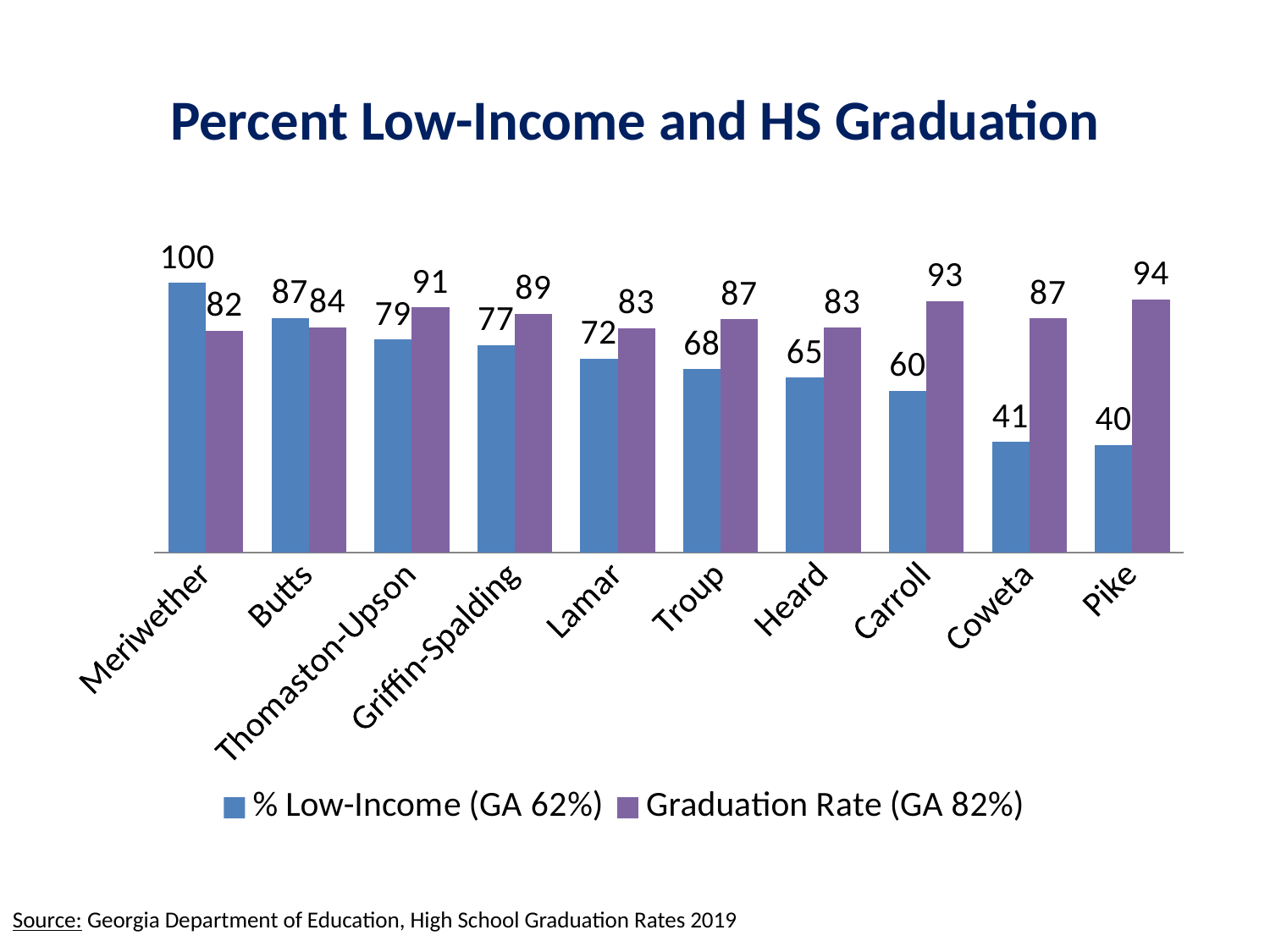
Which county has the lowest % Low-Income value? Pike What is the difference between the Graduation Rate and the % Low-Income value for Pike? 54 What is the Graduation Rate for Carroll? 93 How many counties are shown on the x axis? 10 Which is larger for Butts: the % Low-Income value or the Graduation Rate? % Low-Income What is the title of the chart? Percent Low-Income and HS Graduation What kind of chart is shown on the slide? Bar chart Do the % Low-Income values generally rise or fall from Meriwether to Pike? Fall How many series does the legend list? 2 What is the % Low-Income value for Meriwether? 100 What is the % Low-Income value for Coweta? 41 Which county has the highest Graduation Rate? Pike